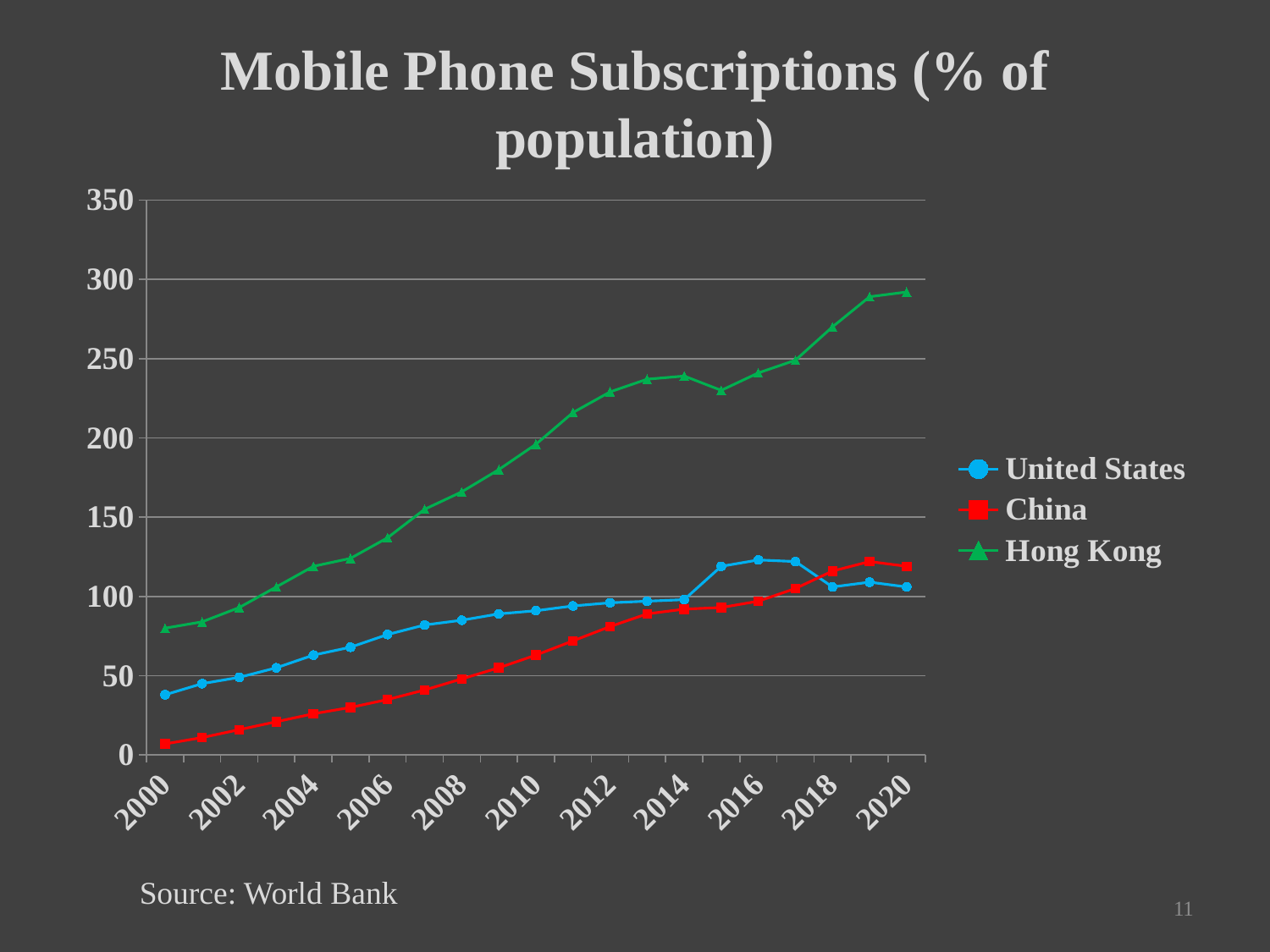
Does the Hong Kong series generally rise or fall from 2000 to 2020? rise How many series does the legend list? 3 What source is cited for the chart data? World Bank Is the value for China in 2000 greater or less than 50? less What kind of chart is shown on the slide? line chart Which series has the lowest value in 2000? China Is the value for the United States in 2016 greater or less than 100? greater Is the value for Hong Kong in 2000 greater or less than 100? less What is the title of the chart? Mobile Phone Subscriptions (% of population) Which series has the highest value in 2020? Hong Kong Which is larger in 2010, the value for the United States or the value for China? United States